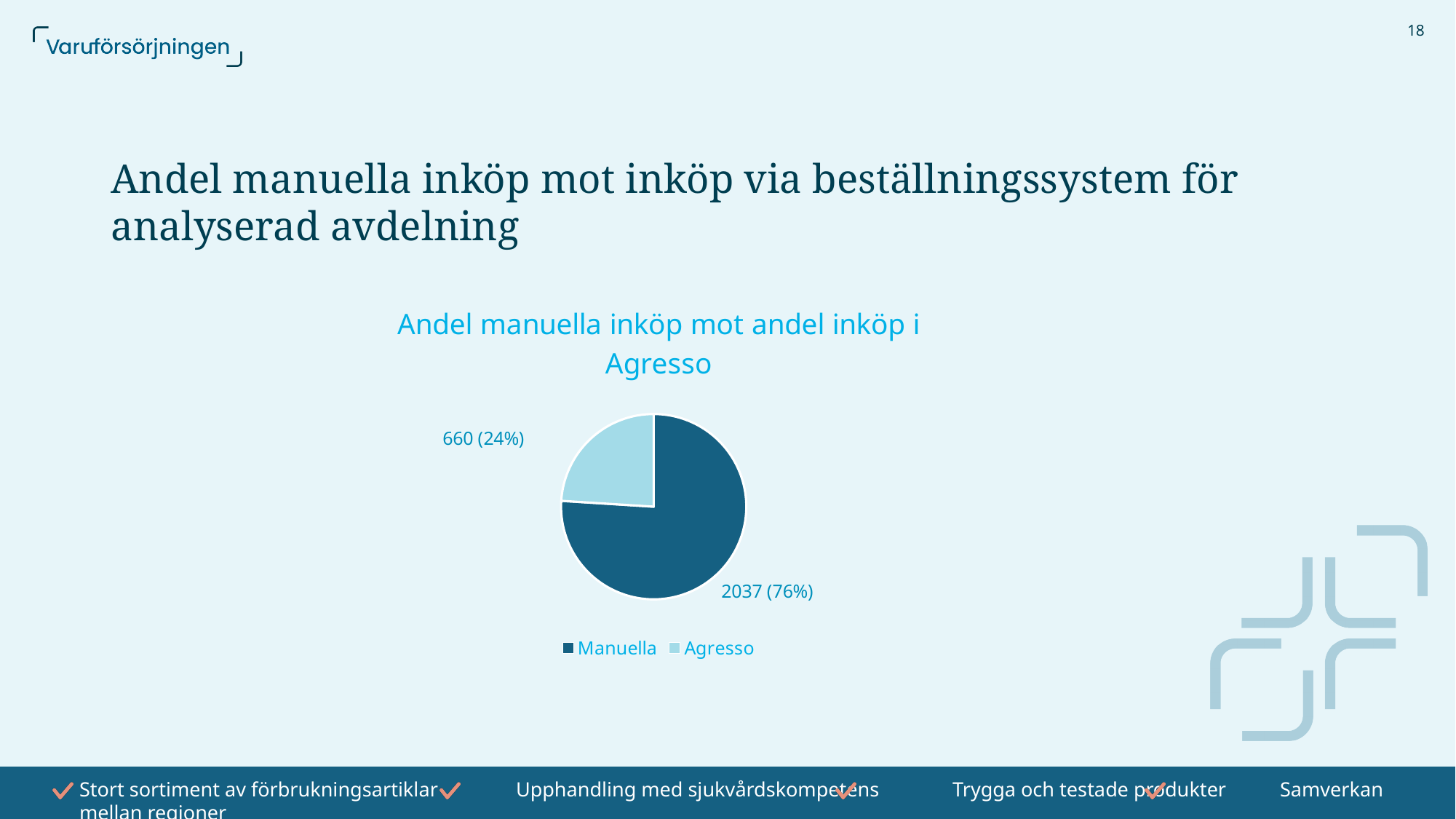
How many slices does the pie chart have? 2 Which slice is the largest? Manuella What is the total of the two slices? 2697 Which slice is the smallest? Agresso What type of chart is shown on the slide? Pie chart What is the title of the chart? Andel manuella inköp mot andel inköp i Agresso What is the data label for the Manuella slice? 2037 (76%) What is the difference between the Manuella count and the Agresso count? 1377 What share of the pie does the Agresso slice represent? 24% What share of the pie does the Manuella slice represent? 76% What is the data label for the Agresso slice? 660 (24%) How many entries does the legend list? 2